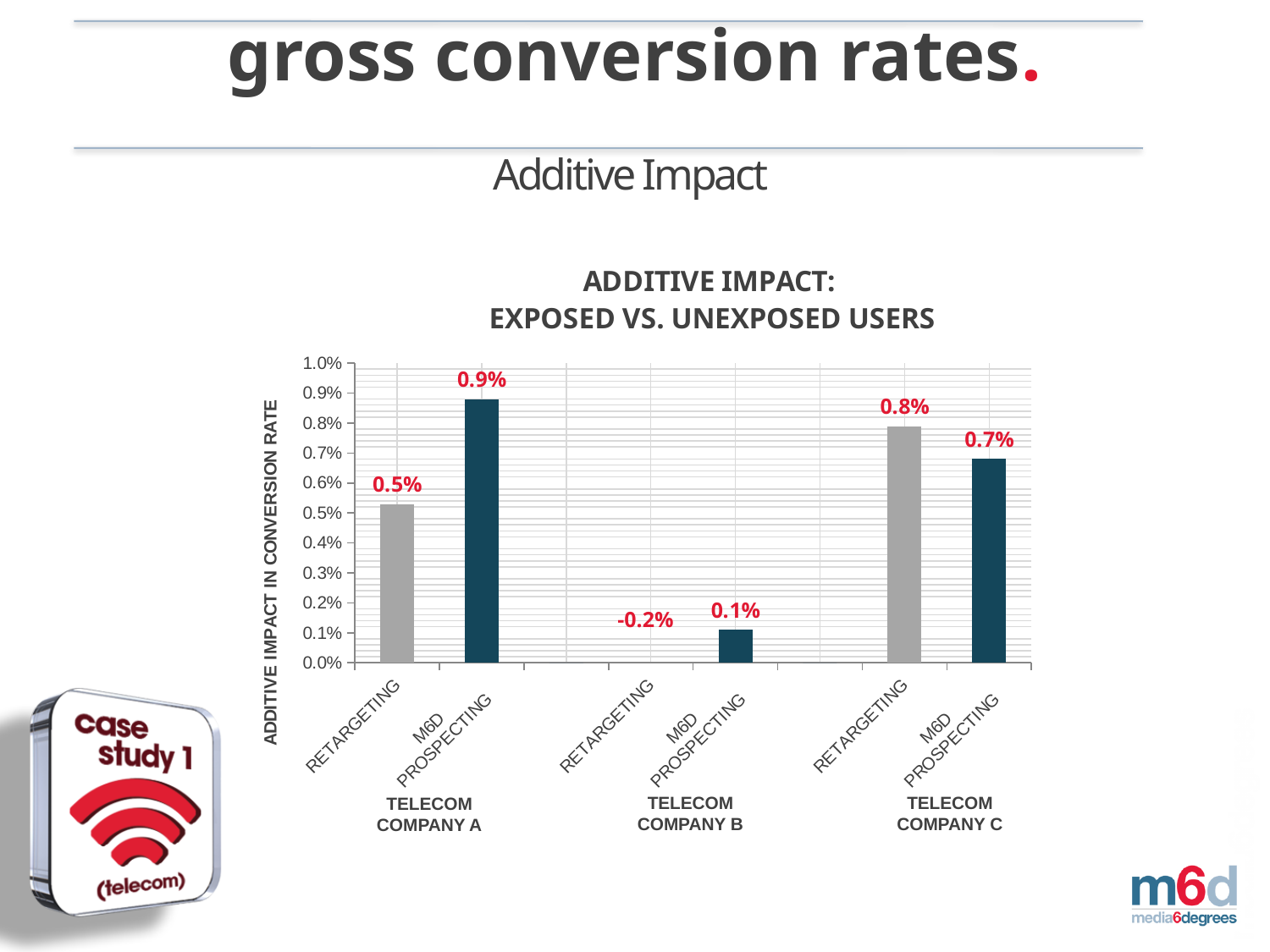
How many bars are plotted in the chart? 5 What is the additive impact in conversion rate for Retargeting at Telecom Company C? 0.8% What is the additive impact in conversion rate for M6D Prospecting at Telecom Company B? 0.1% Which bar shows the highest additive impact in conversion rate? M6D Prospecting, Telecom Company A What kind of chart is shown on the slide? Bar chart What is the title of the chart? ADDITIVE IMPACT: EXPOSED VS. UNEXPOSED USERS What is the additive impact in conversion rate for Retargeting at Telecom Company B? -0.2% What is the additive impact in conversion rate for M6D Prospecting at Telecom Company A? 0.9% Which is larger for Telecom Company C: Retargeting or M6D Prospecting? Retargeting Which bar shows the lowest additive impact in conversion rate? Retargeting, Telecom Company B What is the difference between the M6D Prospecting and Retargeting values for Telecom Company A? 0.4% What is the difference between the Retargeting and M6D Prospecting values for Telecom Company C? 0.1%